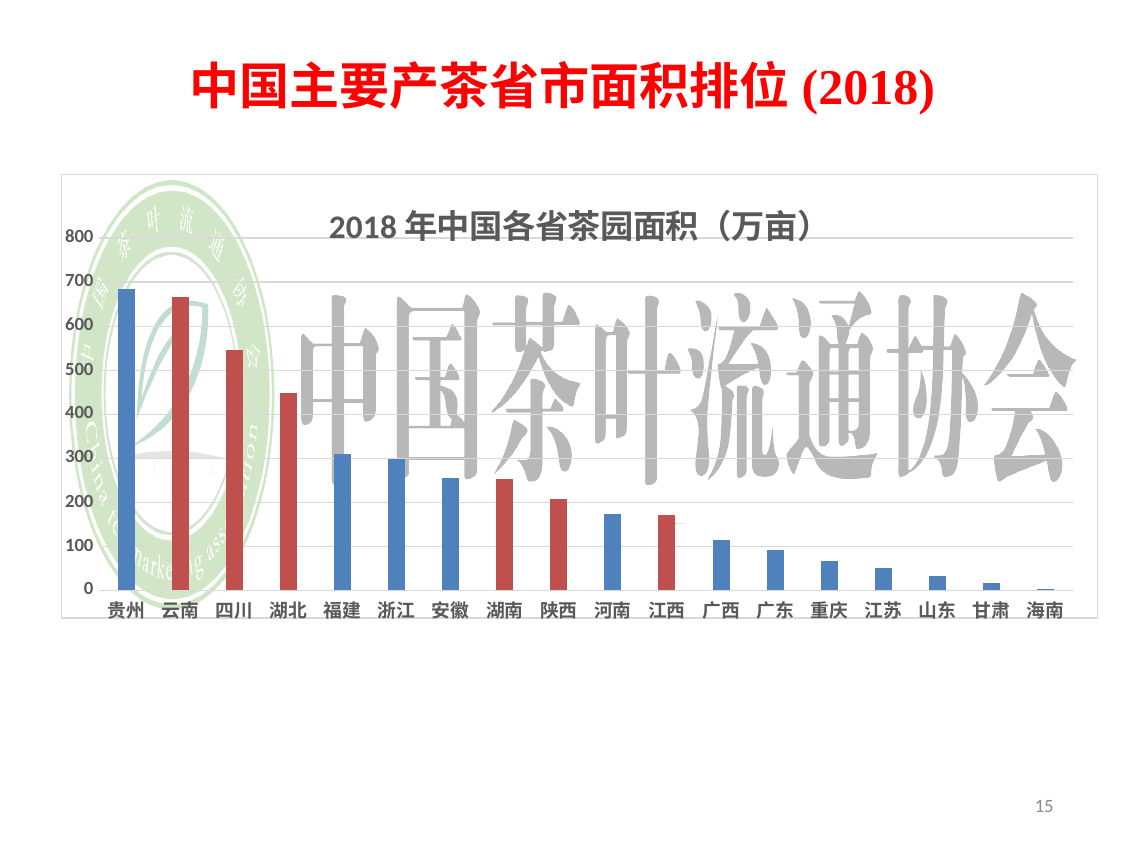
Which has a larger value, 河南 or 广西? 河南 Is the value for 山东 greater or less than 50? less Which province has the lowest tea garden area in the chart? 海南 What kind of chart is shown on the slide? bar chart What is the title of the chart? 2018 年中国各省茶园面积（万亩） How many provinces are shown on the x axis of the chart? 18 Is the value for 四川 greater or less than 500? greater Is the value for 湖北 greater or less than 500? less Do the values rise or fall moving from left to right along the x axis? fall Which has a larger value, 四川 or 湖北? 四川